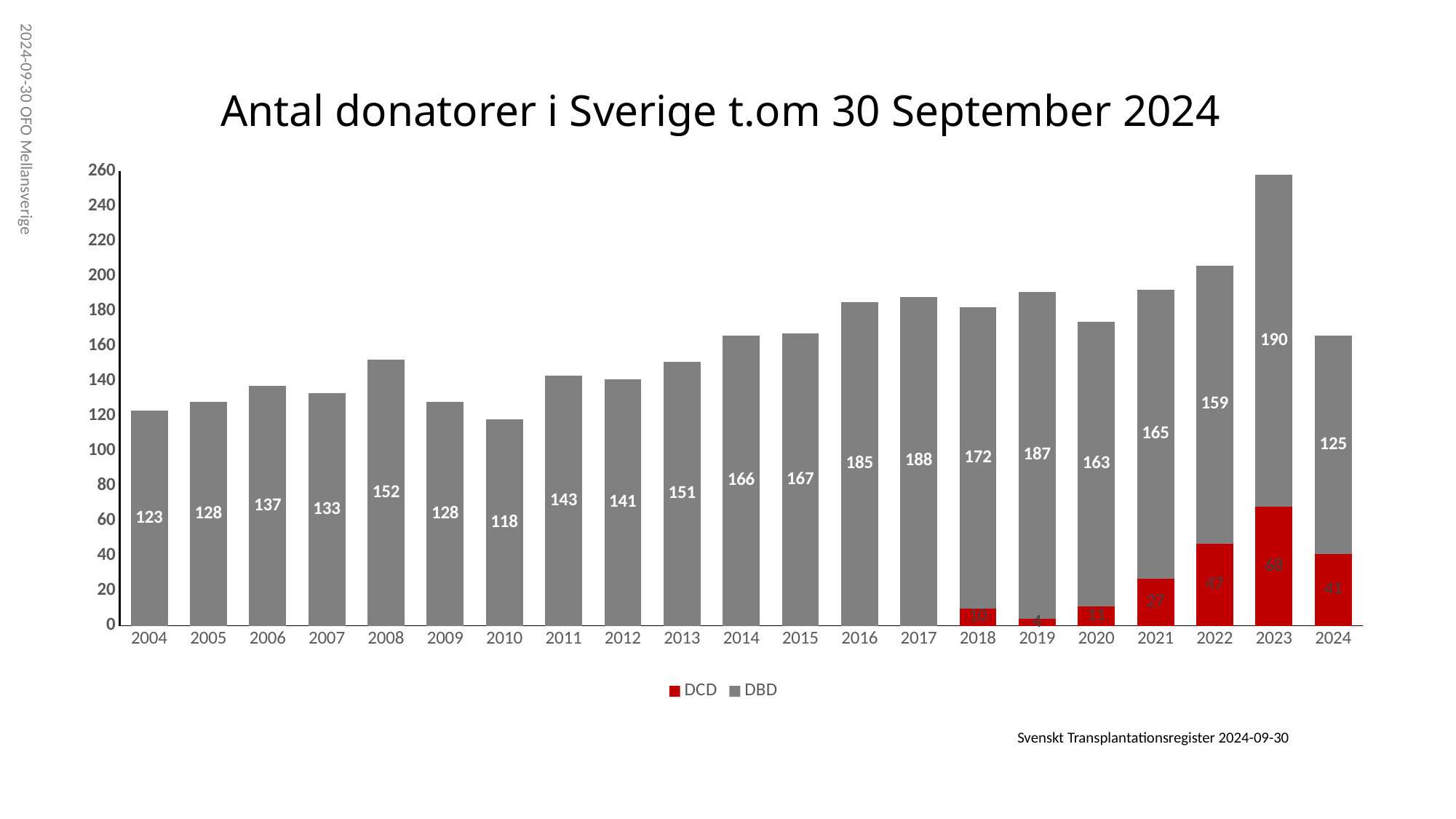
Which year has the lowest DBD value? 2010 What is the DCD value for 2022? 47 What is the total of the stacked bar for 2023? 258 Do the DCD values rise or fall from 2020 to 2023? rise How many years are shown on the x axis? 21 Which year has the larger DBD value, 2014 or 2015? 2015 How many series does the legend list? 2 Which year has the highest DBD value? 2023 What is the difference between the DBD values for 2017 and 2016? 3 What kind of chart is shown on the slide? bar chart Which colour represents the DCD series in the legend? red What is the DBD value for 2023? 190